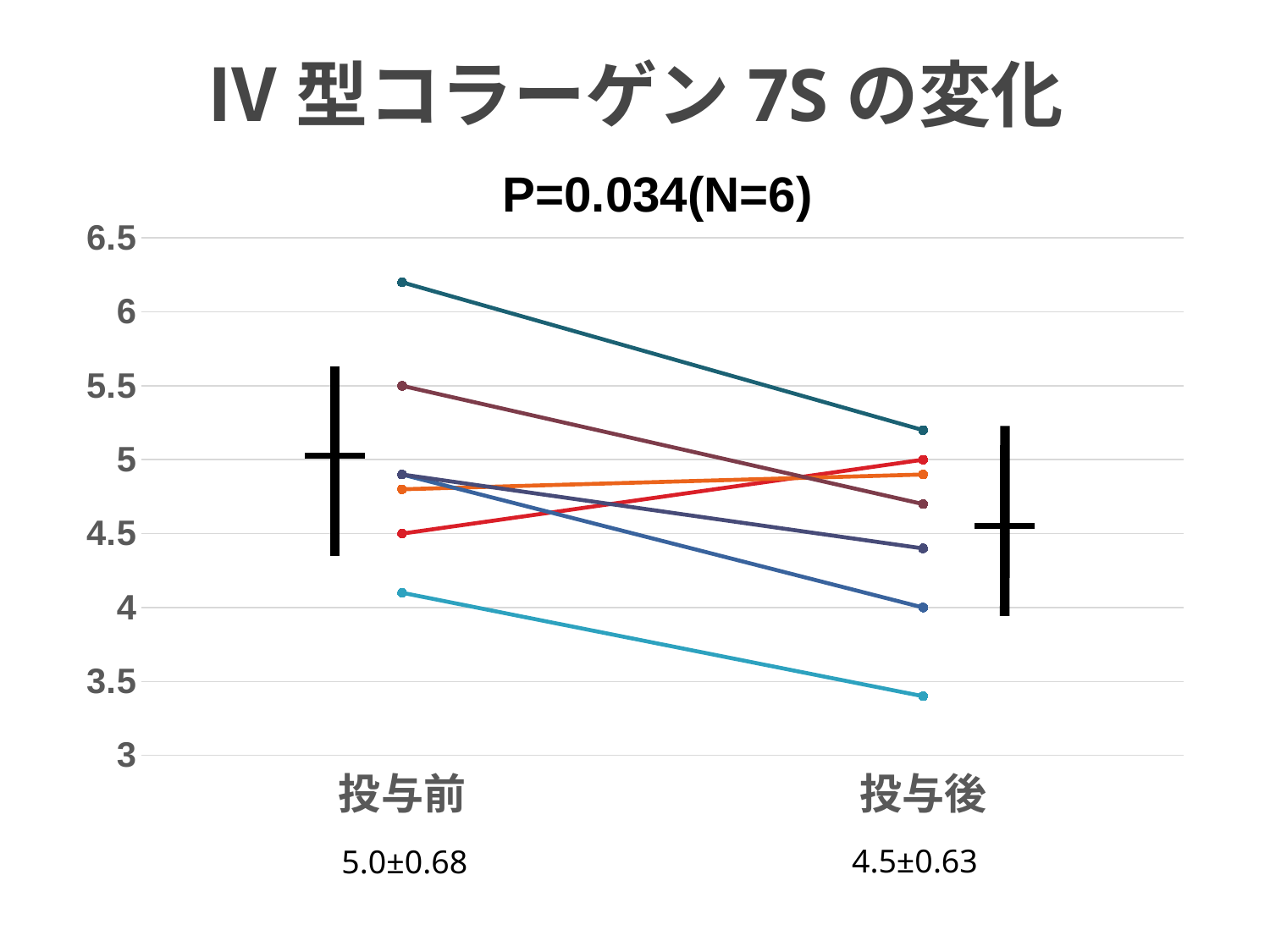
What is the title of the chart? IV 型コラーゲン 7S の変化 Which category has the higher printed mean value, 投与前 or 投与後? 投与前 What is the difference between the printed mean for 投与前 (5.0) and the printed mean for 投与後 (4.5)? 0.5 Is the highest plotted point at 投与前 greater or less than 6? greater What mean ± SD value is printed under 投与前? 5.0±0.68 What kind of chart is shown on the slide? line chart Is the lowest plotted point at 投与後 greater or less than 3.5? less How many categories are shown on the x axis? 2 How many individual lines are plotted in the chart? 7 Overall, do the values rise or fall from 投与前 to 投与後? fall What P value is printed above the chart? P=0.034 What mean ± SD value is printed under 投与後? 4.5±0.63